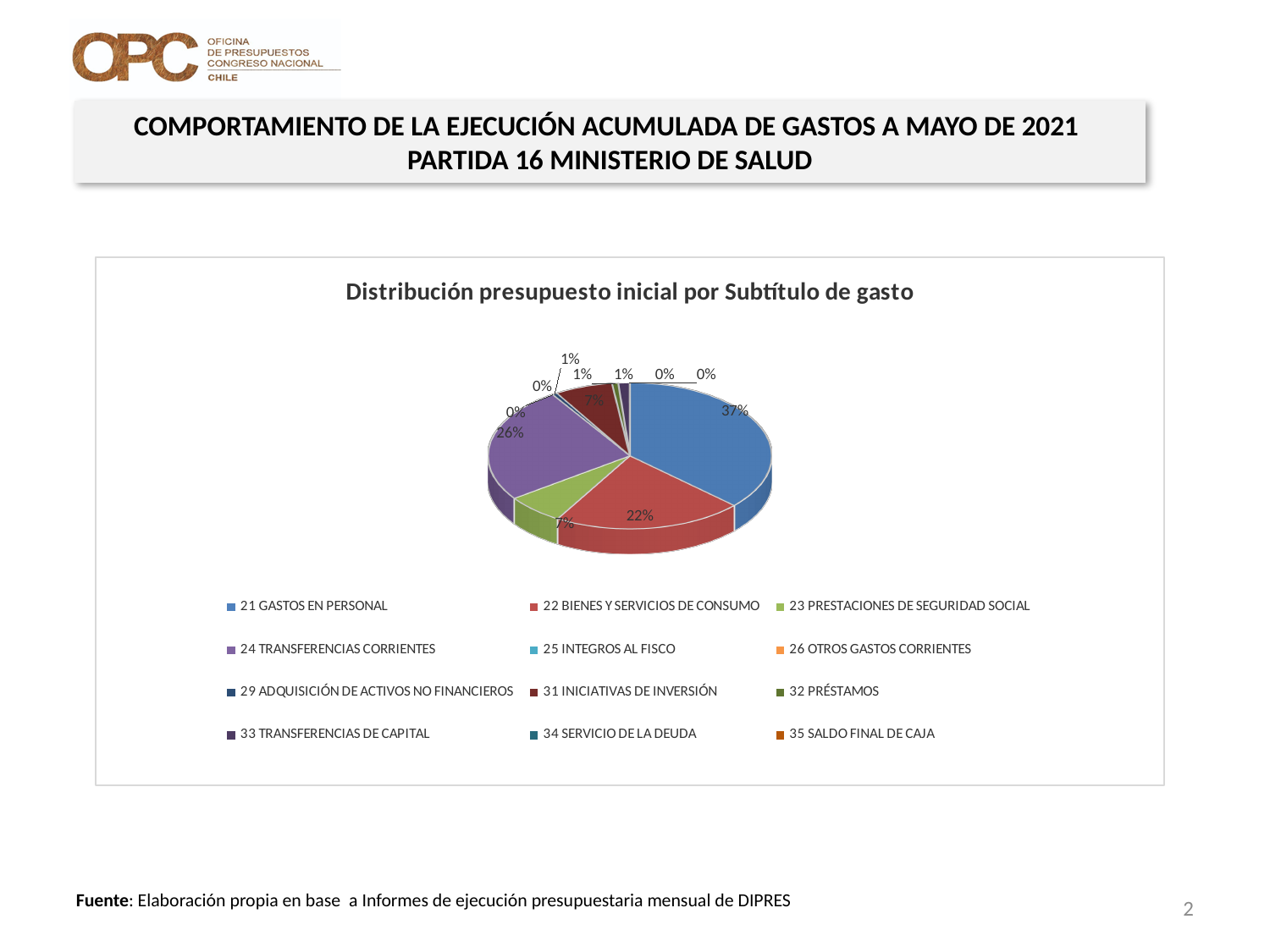
Which is larger, the slice for 22 BIENES Y SERVICIOS DE CONSUMO or the slice for 24 TRANSFERENCIAS CORRIENTES? 24 TRANSFERENCIAS CORRIENTES What is the title of the chart? Distribución presupuesto inicial por Subtítulo de gasto How many categories does the legend of the pie chart list? 12 What is the difference in percentage points between 21 GASTOS EN PERSONAL and 22 BIENES Y SERVICIOS DE CONSUMO? 15 percentage points What colour is the slice for 21 GASTOS EN PERSONAL? Blue What percentage is shown for 23 PRESTACIONES DE SEGURIDAD SOCIAL? 7% What percentage is shown for 31 INICIATIVAS DE INVERSIÓN? 7% What percentage is shown for 22 BIENES Y SERVICIOS DE CONSUMO? 22% What kind of chart is shown on the slide? Pie chart What share of the pie does 21 GASTOS EN PERSONAL represent? 37% Which category has the largest slice of the pie? 21 GASTOS EN PERSONAL What percentage is shown for 24 TRANSFERENCIAS CORRIENTES? 26%